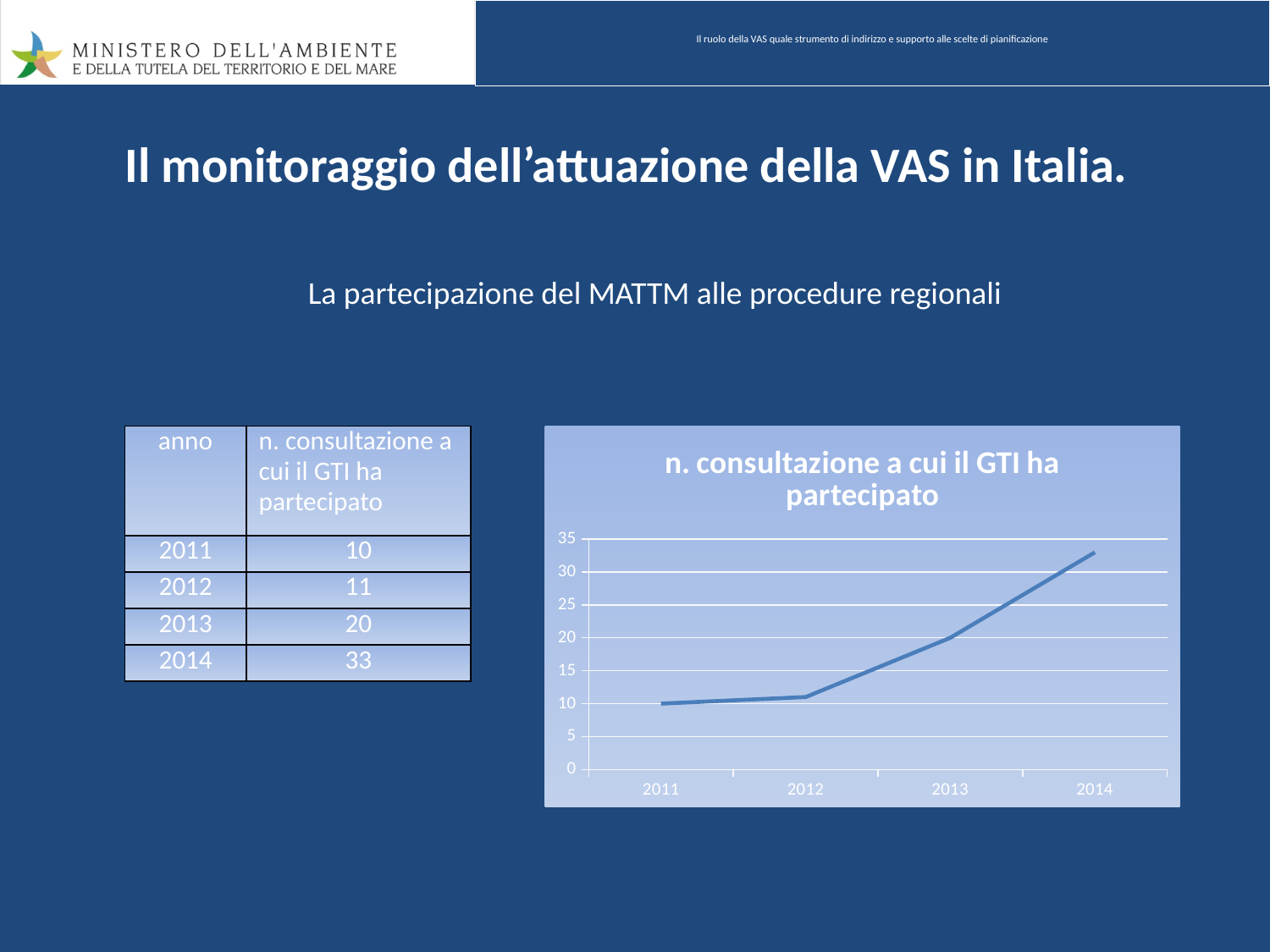
What is the value plotted for 2014? 33 What is the difference between the values for 2014 and 2013? 13 What kind of chart is shown on the slide? line chart What is the value plotted for 2013? 20 What is the value plotted for 2012? 11 Do the values rise or fall from 2011 to 2014? rise What is the title of the chart? n. consultazione a cui il GTI ha partecipato How many years are plotted on the x axis of the chart? 4 Which year has the lowest value in the chart? 2011 Is the value for 2014 greater or less than 30? greater Which year has the highest value in the chart? 2014 What is the value plotted for 2011? 10